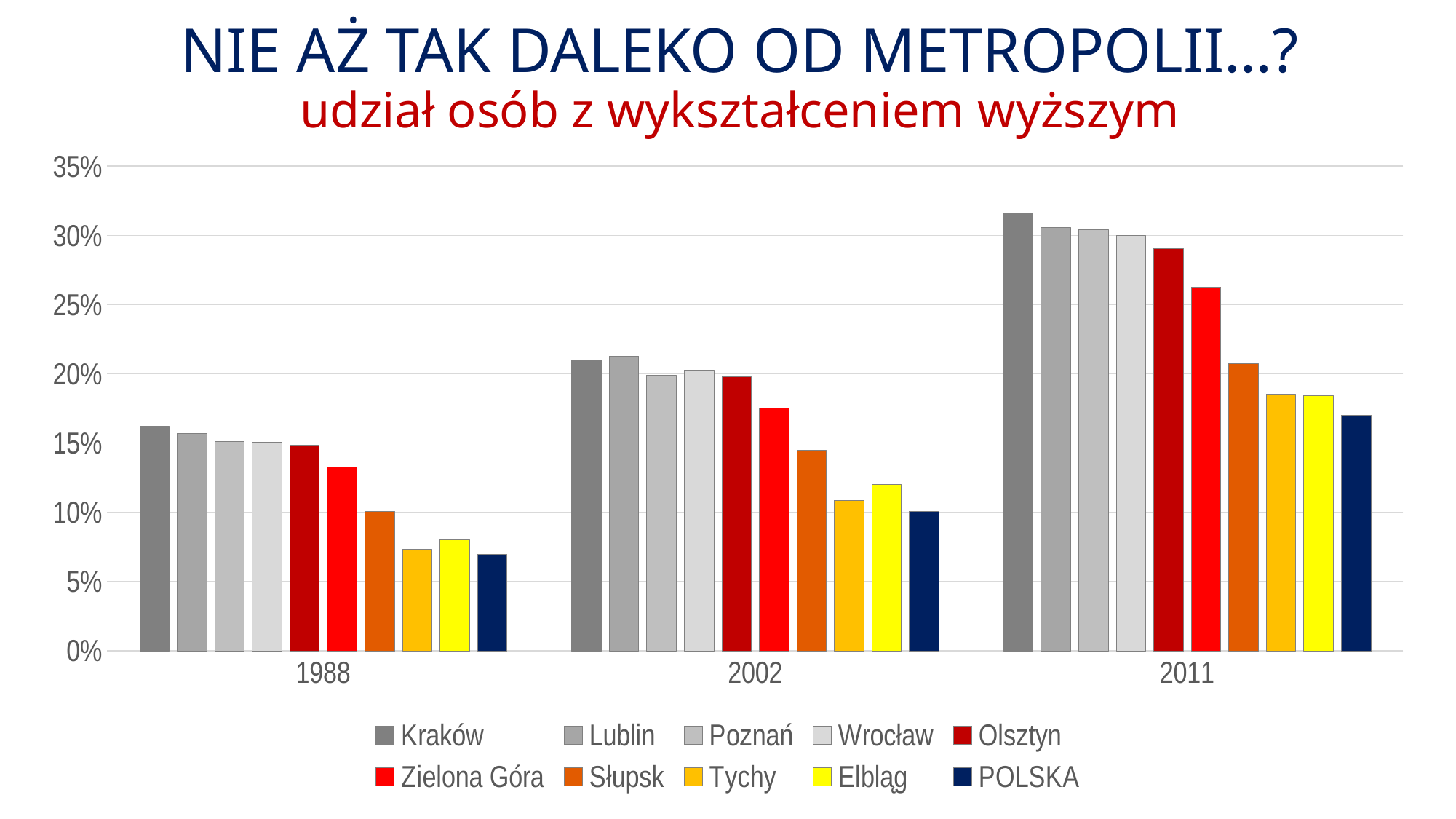
How many series does the legend list? 10 What kind of chart is shown on the slide? bar chart Is the value for Kraków in 2011 greater or less than 30%? greater Which city has the highest value in 2011? Kraków In 2011, which is larger: the value for Kraków or the value for Słupsk? Kraków Is the value for Słupsk in 2002 greater or less than 15%? less How many year categories are shown on the x axis? 3 Which series has the lowest value in 2011? POLSKA Is the value for Zielona Góra in 2011 greater or less than 25%? greater What colour are the POLSKA bars? dark navy blue Do the values for POLSKA rise or fall from 1988 to 2011? rise